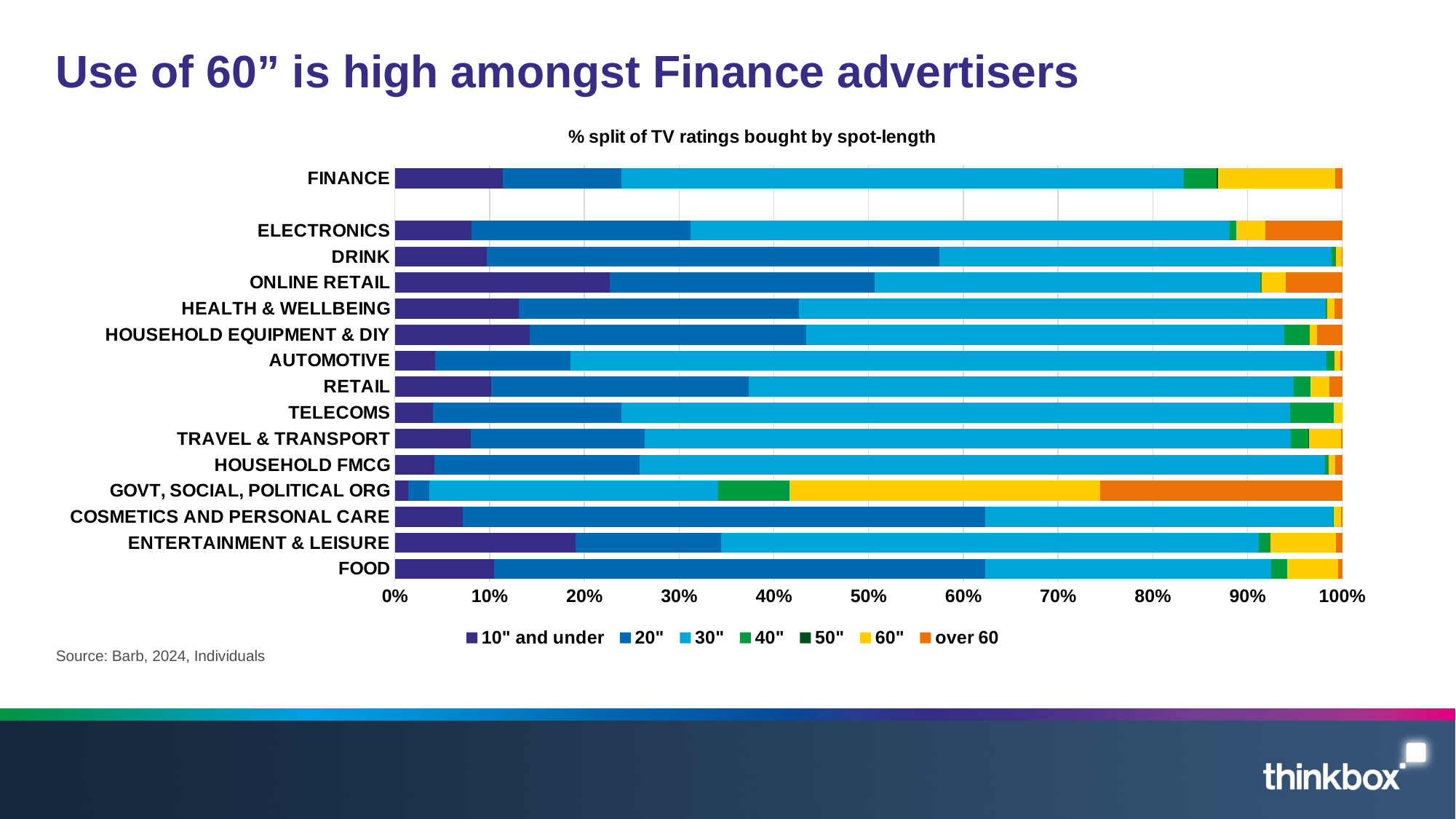
How many advertiser categories are plotted on the chart? 15 Which category has the smallest '10" and under' share? GOVT, SOCIAL, POLITICAL ORG How many series does the legend list? 7 Is the 'over 60' share for GOVT, SOCIAL, POLITICAL ORG greater or less than 20%? greater What is the title of the chart? % split of TV ratings bought by spot-length Which category has the largest 60" share? GOVT, SOCIAL, POLITICAL ORG Is the '10" and under' share for ONLINE RETAIL greater or less than 20%? greater What kind of chart is shown on the slide? Stacked bar chart Which has the larger '10" and under' share, FINANCE or AUTOMOTIVE? FINANCE Which spot-length series is shown in yellow in the legend? 60" Which has the larger 60" share, FINANCE or ELECTRONICS? FINANCE Which category has the largest 'over 60' share? GOVT, SOCIAL, POLITICAL ORG